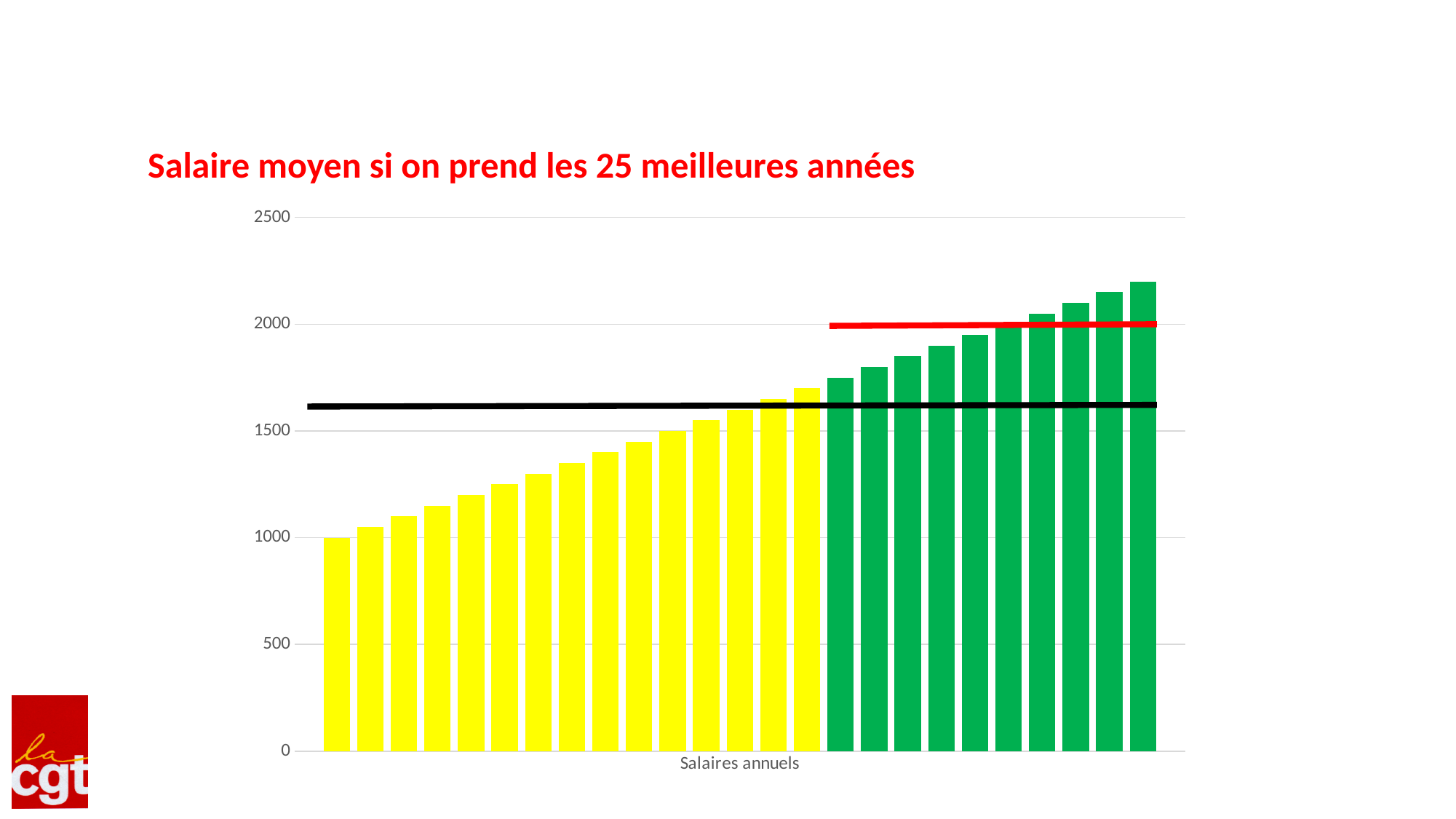
How many bars are plotted in the chart? 25 What kind of chart is shown on the slide? bar chart Which bar is the highest: the leftmost bar or the rightmost bar? the rightmost bar Do the bar values rise or fall from left to right along the x axis? rise Which is larger: the value of the first green bar or the value of the last yellow bar? the first green bar Is the value of the rightmost bar greater or less than 2000? greater What is the title of the chart? Salaire moyen si on prend les 25 meilleures années What is the highest value shown on the y axis? 2500 What is the label shown on the x axis? Salaires annuels Is the value of the leftmost bar greater or less than 1500? less Which bar is the lowest in the chart? the leftmost bar Is the value of the leftmost bar greater or less than 500? greater